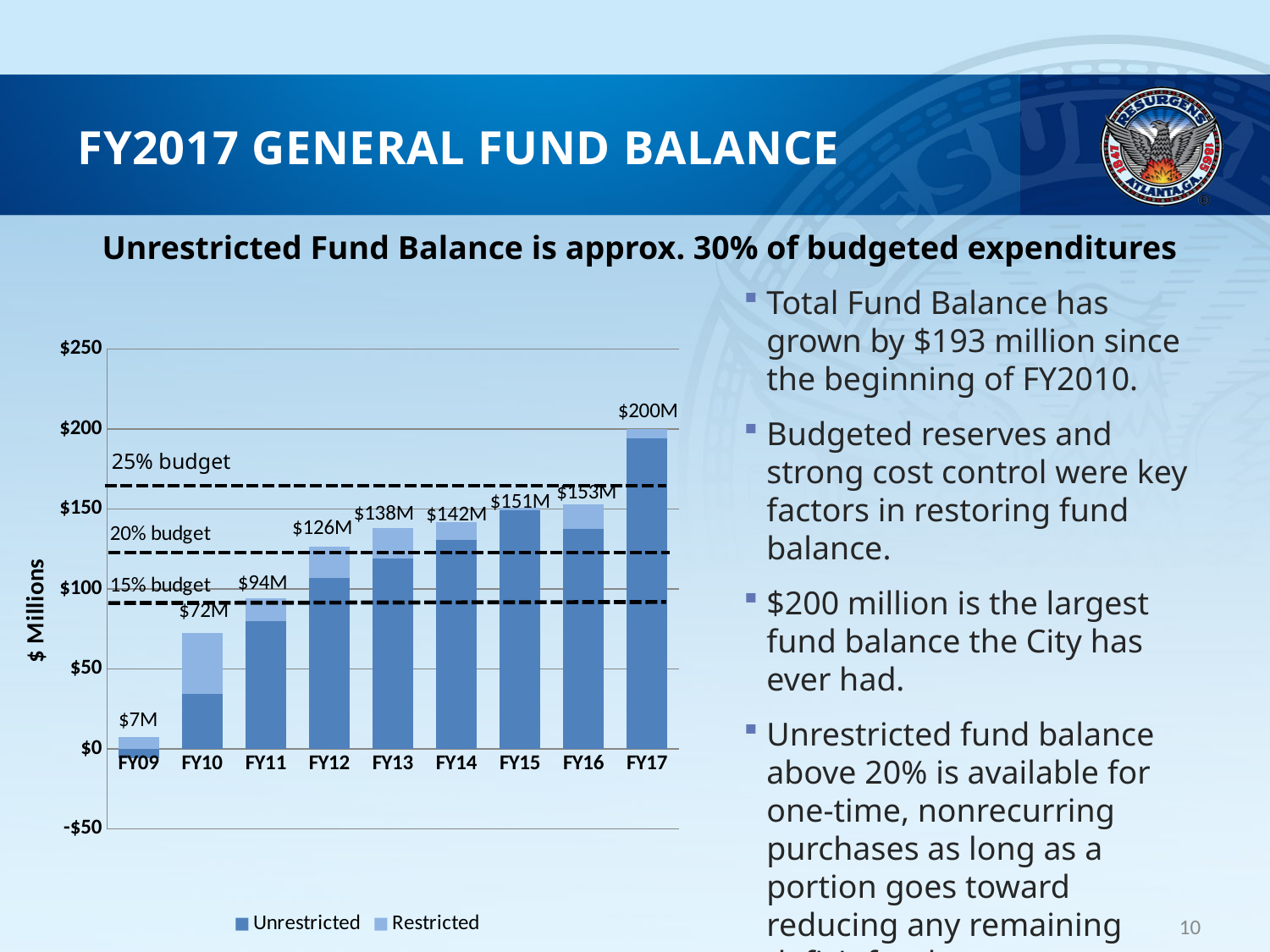
Which fiscal year has the lowest total fund balance? FY09 Is the unrestricted portion of the FY10 bar greater or less than $50 million? less What is the total fund balance labeled for FY13? $138M What is the total fund balance labeled for FY17? $200M How many series does the chart legend list? 2 Which is larger, the total fund balance for FY12 or for FY11? FY12 Do the total fund balances rise or fall from FY09 to FY17? Rise What is the total fund balance labeled for FY09? $7M What is the difference between the total fund balance in FY17 and FY16? $47M Which fiscal year has the highest total fund balance? FY17 How many fiscal years are shown on the x axis of the chart? 9 What kind of chart is shown on the slide? Stacked bar chart